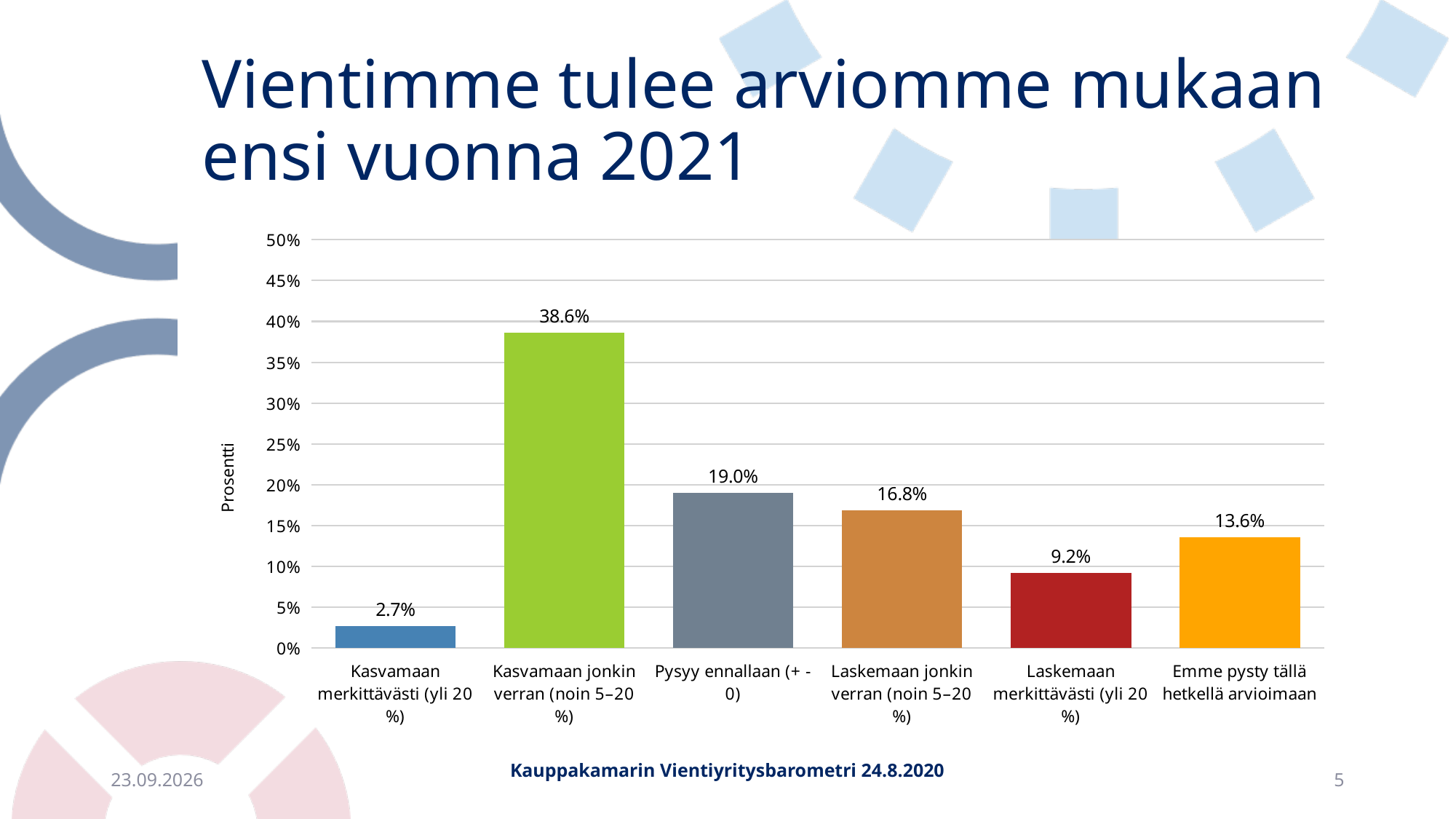
How many categories are shown on the x axis? 6 What kind of chart is shown on the slide? Bar chart Which is larger, the value for "Laskemaan merkittävästi (yli 20 %)" or the value for "Emme pysty tällä hetkellä arvioimaan"? Emme pysty tällä hetkellä arvioimaan What is the value for "Pysyy ennallaan (+ - 0)"? 19.0% What is the value for "Kasvamaan jonkin verran (noin 5–20 %)"? 38.6% What colour is the bar for "Kasvamaan jonkin verran (noin 5–20 %)"? Green Which category has the lowest value? Kasvamaan merkittävästi (yli 20 %) What is the label of the vertical axis? Prosentti What is the difference between the values for "Pysyy ennallaan (+ - 0)" and "Laskemaan jonkin verran (noin 5–20 %)"? 2.2% Which category has the highest value? Kasvamaan jonkin verran (noin 5–20 %) Is the value for "Kasvamaan jonkin verran (noin 5–20 %)" greater or less than 35%? greater What is the value for "Emme pysty tällä hetkellä arvioimaan"? 13.6%